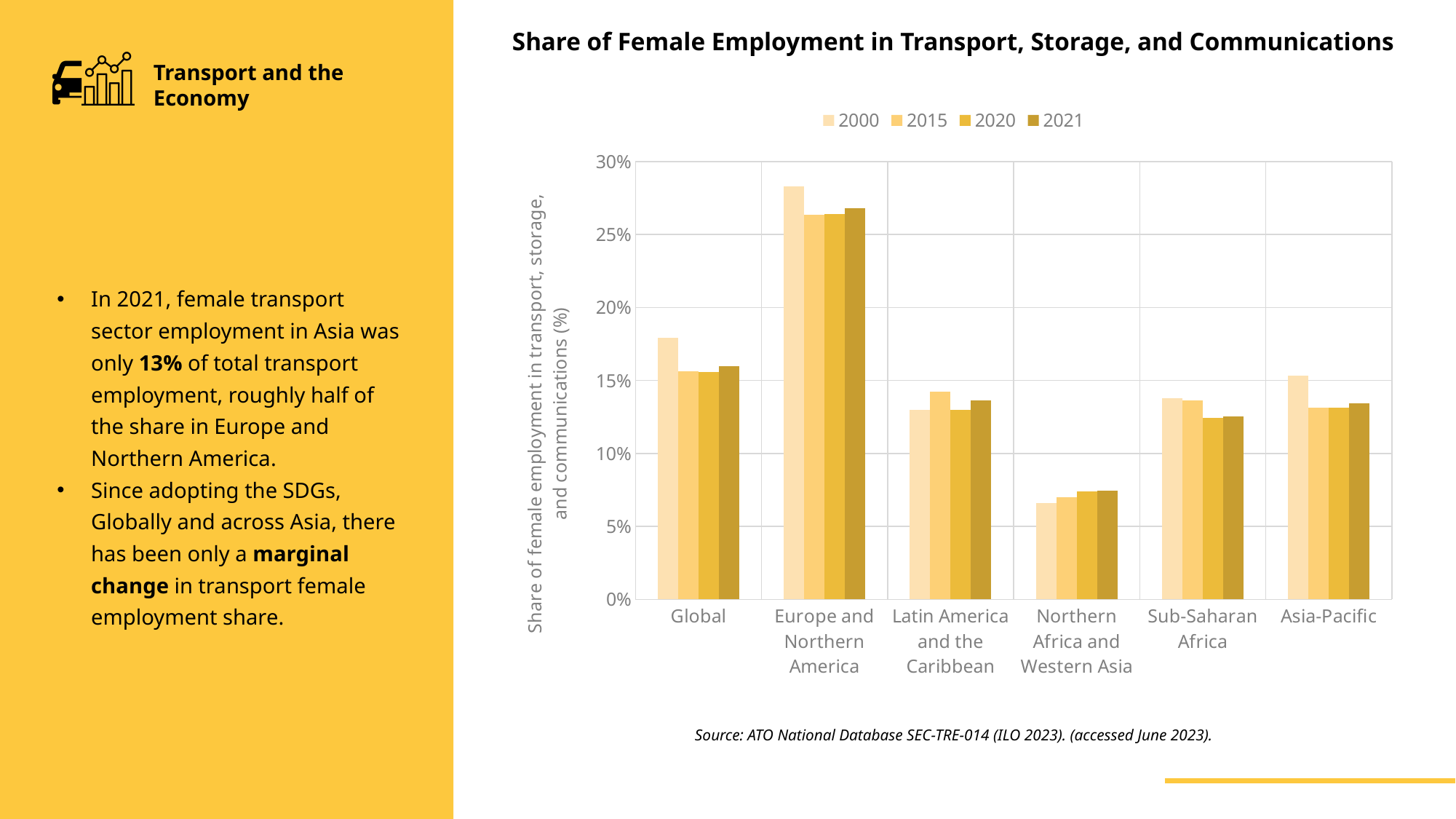
Which is larger, the 2000 value for Global or the 2000 value for Asia-Pacific? Global Is the value for Northern Africa and Western Asia in 2000 greater or less than 10%? less What kind of chart is shown on the slide? Bar chart How many series does the legend list? 4 Which region has the highest share of female employment in 2021? Europe and Northern America How many regions are shown on the x axis? 6 What is the title of the chart? Share of Female Employment in Transport, Storage, and Communications Which region has the lowest share of female employment in 2021? Northern Africa and Western Asia Is the value for Europe and Northern America in 2021 greater or less than 25%? greater Is the value for Global in 2000 greater or less than 15%? greater Which years are listed in the chart legend? 2000, 2015, 2020, 2021 Do the values for Northern Africa and Western Asia rise or fall from 2000 to 2021? rise